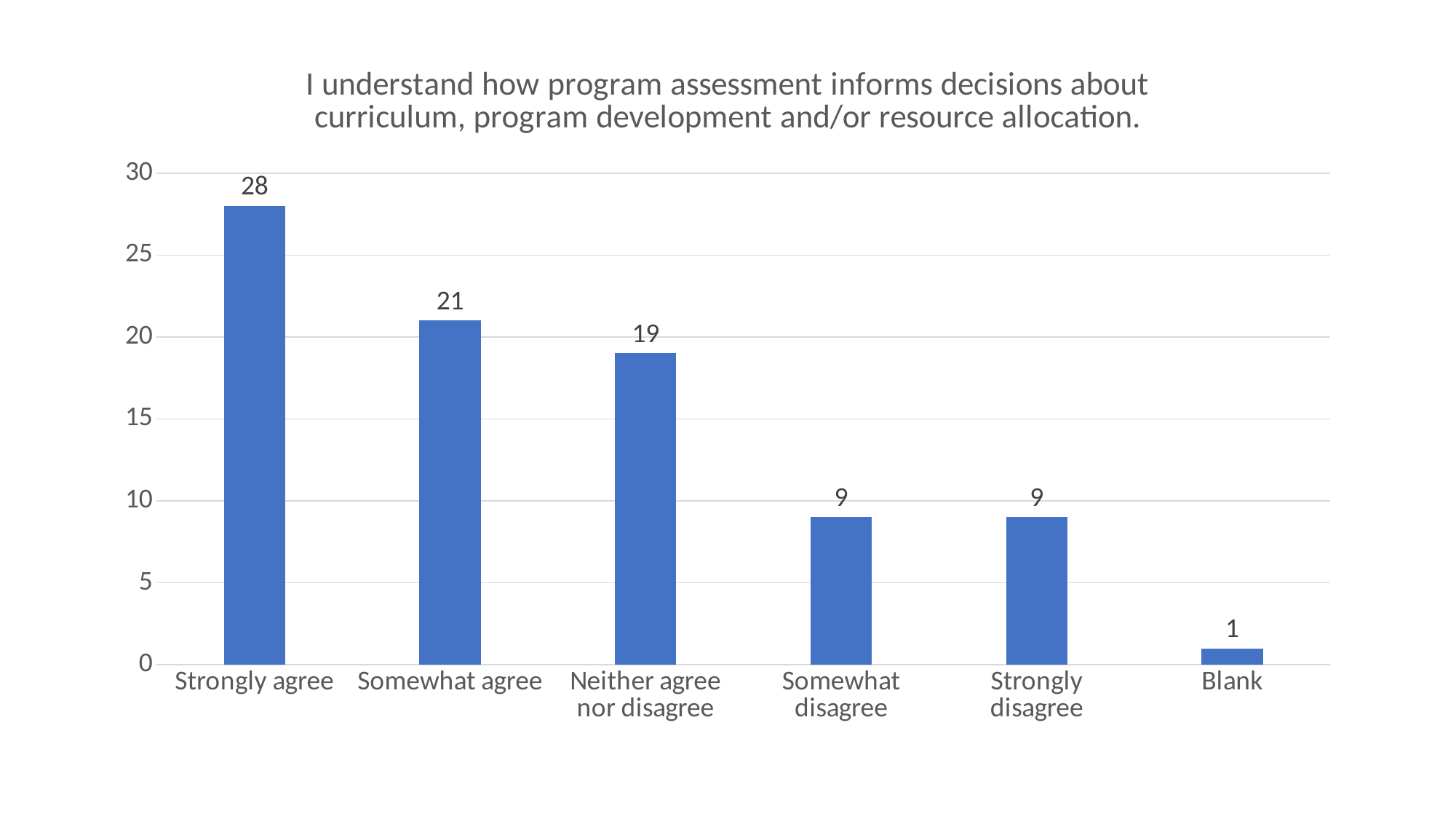
Which category has the highest value? Strongly agree What is the value for Strongly agree? 28 How many categories are shown on the x axis? 6 Which category has the lowest value? Blank What is the value for Neither agree nor disagree? 19 What is the value for Blank? 1 What is the difference between Somewhat agree and Somewhat disagree? 12 Is the value for Neither agree nor disagree greater or less than 15? greater What kind of chart is this? bar chart What is the title of the chart? I understand how program assessment informs decisions about curriculum, program development and/or resource allocation. Which is larger, Somewhat agree or Neither agree nor disagree? Somewhat agree What is the difference between Strongly agree and Somewhat agree? 7